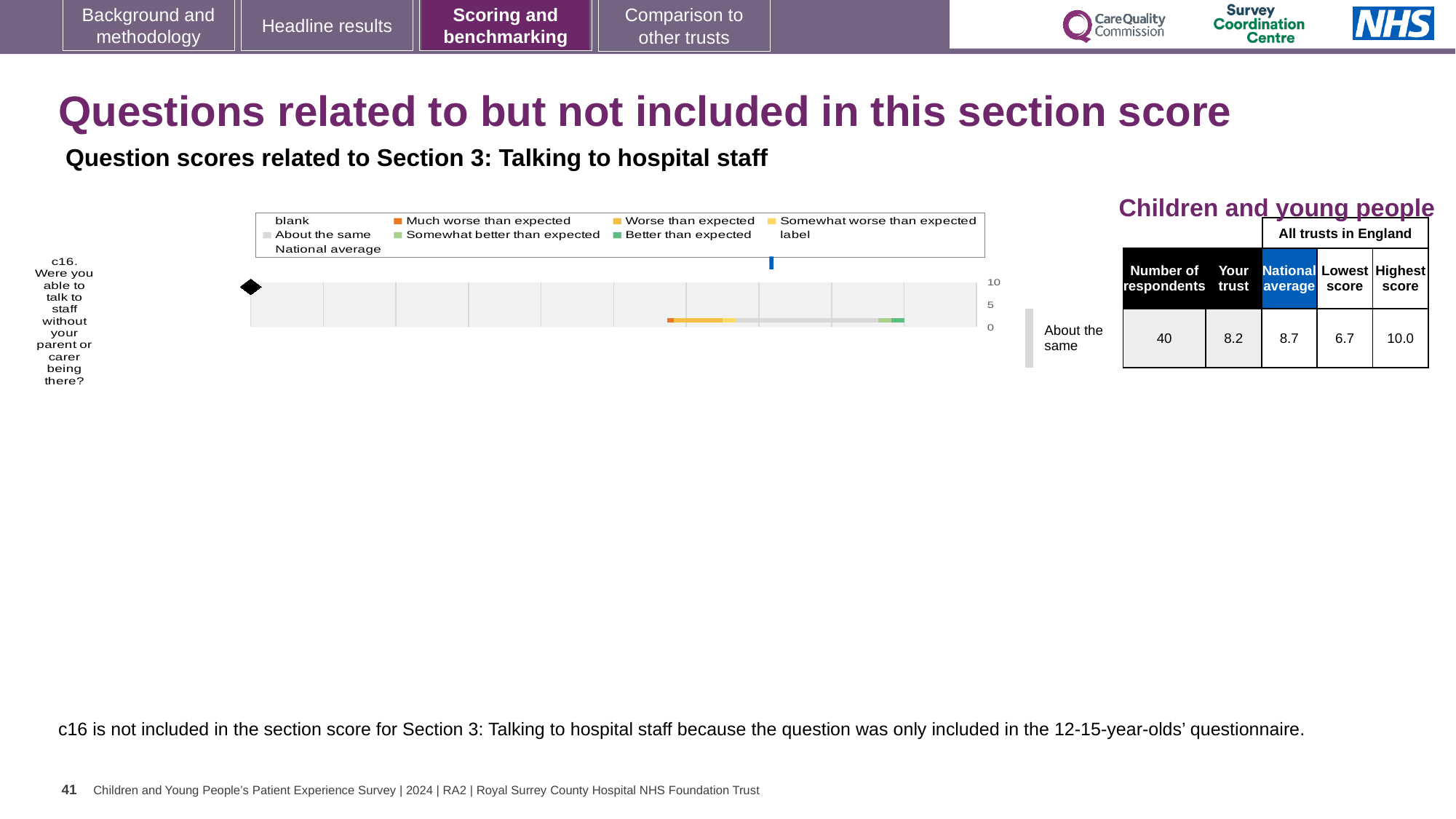
What is the difference between the highest and lowest scores among all trusts for question c16? 3.3 What kind of chart is used to show the c16 question score? bar chart What is the national average score for question c16? 8.7 What is the 'Your trust' score for question c16? 8.2 How many respondents answered question c16? 40 What is the difference between the national average and the 'Your trust' score for question c16? 0.5 What is the lowest score among all trusts in England for question c16? 6.7 Which benchmark category is the trust's result for question c16 placed in? About the same Is the 'Your trust' score for question c16 greater or less than 5? greater What is the highest score among all trusts in England for question c16? 10.0 Which is larger for question c16: the 'Your trust' score or the national average? National average How many survey questions are plotted on the chart? 1